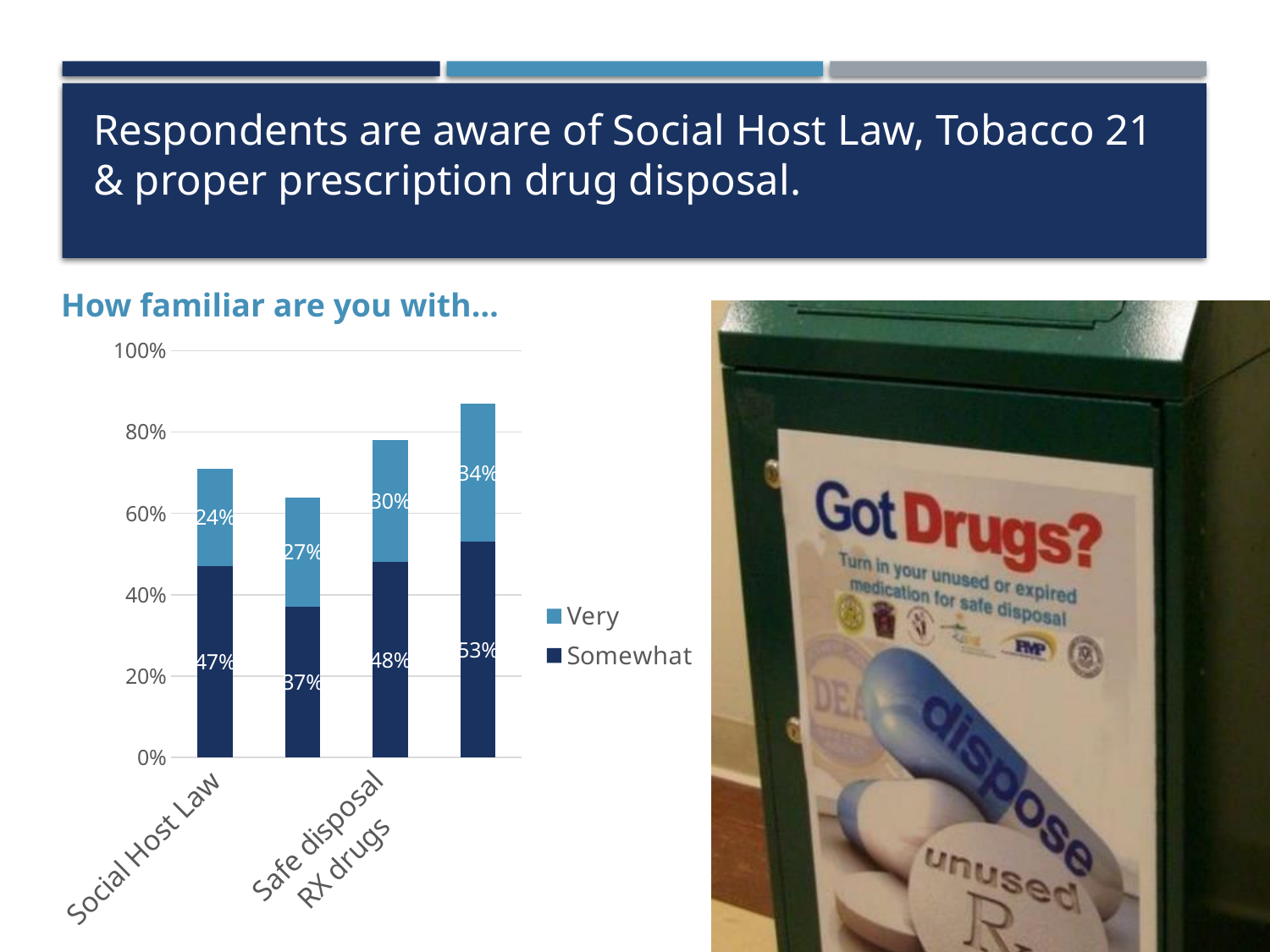
What are the two entries in the chart's legend? Very and Somewhat What is the combined total of the Social Host Law bar (Very plus Somewhat)? 71% What is the "Very" value for Safe disposal RX drugs? 30% What is the combined total of the Safe disposal RX drugs bar (Very plus Somewhat)? 78% What kind of chart is shown on the slide? Stacked bar chart What is the "Somewhat" value for Safe disposal RX drugs? 48% What is the "Very" value for Social Host Law? 24% What is the "Somewhat" value for Social Host Law? 47% How many series does the legend list? 2 What is the difference between the "Very" values for Safe disposal RX drugs and Social Host Law? 6% Is the total height of the Social Host Law bar greater or less than 60%? greater Which has a larger "Very" value, Social Host Law or Safe disposal RX drugs? Safe disposal RX drugs